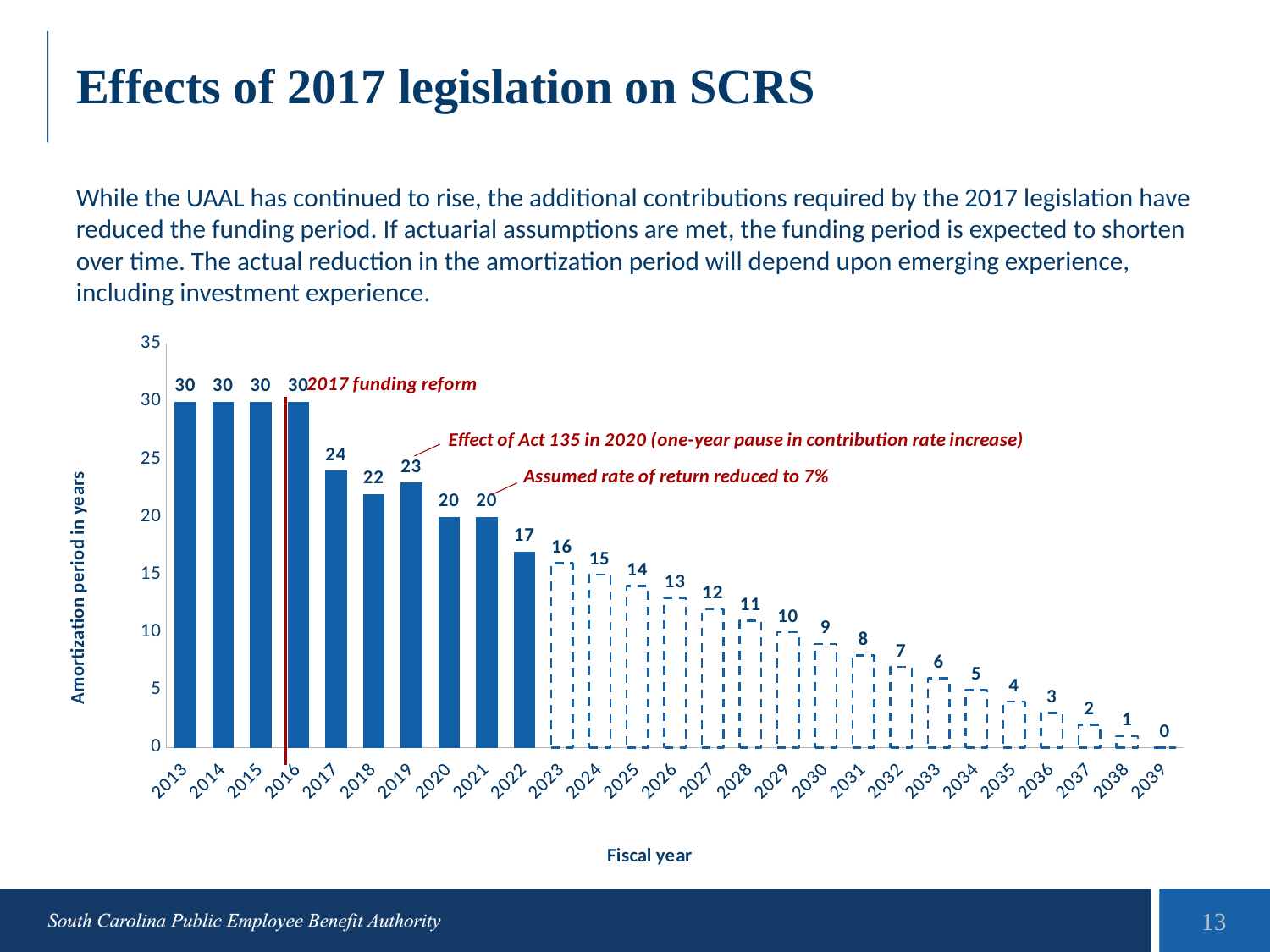
What is the amortization period in years for fiscal year 2013? 30 Do the amortization period values rise or fall from fiscal year 2022 to fiscal year 2039? Fall Which fiscal year has the lowest amortization period shown on the chart? 2039 What is the difference in amortization period between fiscal year 2017 and fiscal year 2018? 2 What is the label of the y axis on the chart? Amortization period in years Which has a longer amortization period, fiscal year 2019 or fiscal year 2020? 2019 What is the amortization period in years for fiscal year 2022? 17 How many fiscal years are shown on the x axis of the chart? 27 What kind of chart is shown on the slide? Bar chart What event does the red vertical line on the chart mark? 2017 funding reform What is the amortization period in years for fiscal year 2030? 9 What is the amortization period in years for fiscal year 2017? 24